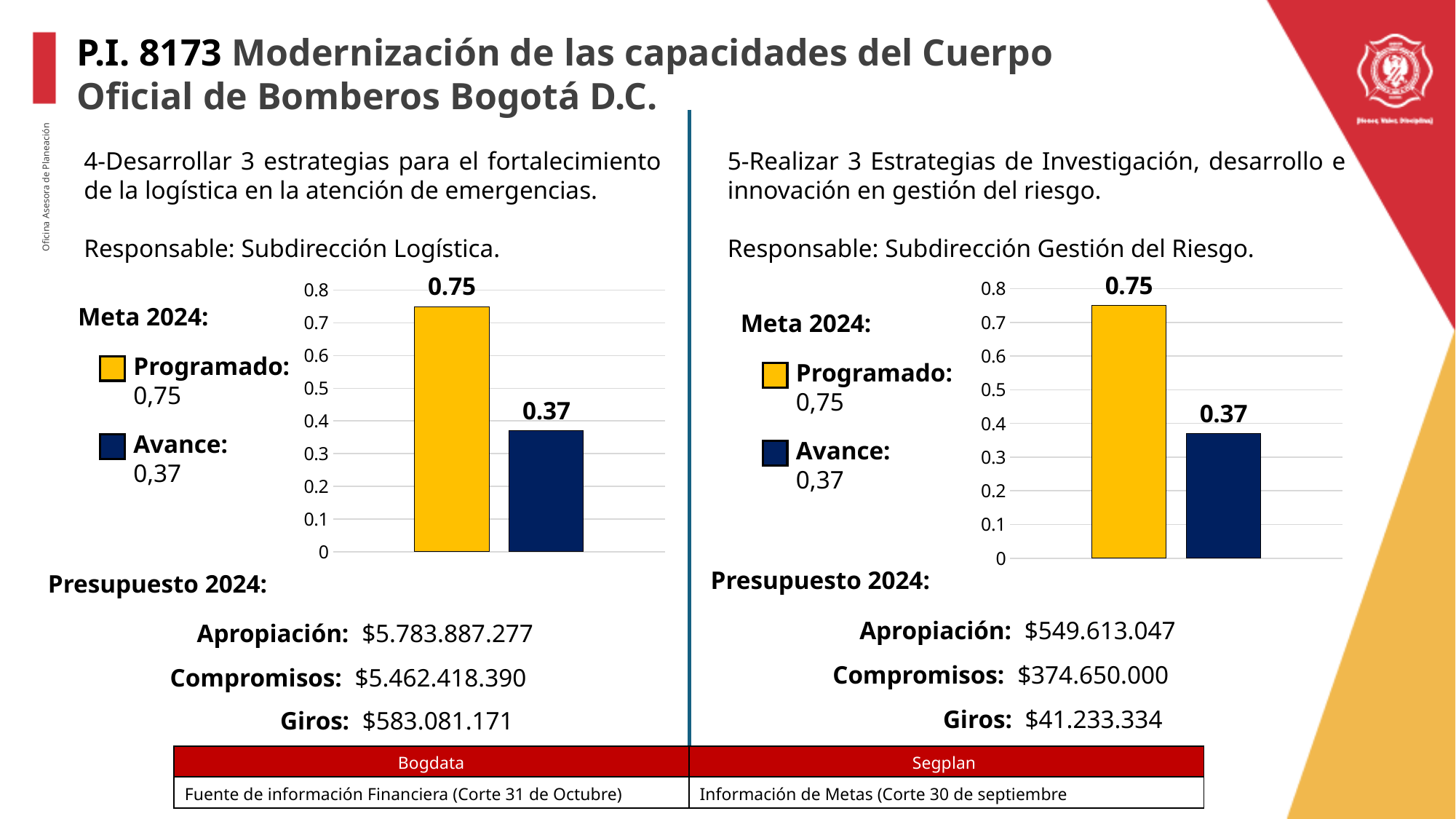
How many bars are plotted in the right chart? 2 In the left chart, what colour is the Programado bar? Yellow What type of chart is used on the left side of the slide? Bar chart In the left chart, what is the difference between the Programado and Avance values? 0.38 In the left chart, is the Avance value greater or less than 0.4? less In the left chart, which bar is higher, Programado or Avance? Programado In the right chart, which bar is the lowest? Avance In the left chart (goal 4, Subdirección Logística), what is the value of the Programado bar? 0.75 In the right chart (goal 5, Subdirección Gestión del Riesgo), what is the value of the Avance bar? 0.37 In the right chart, what is the difference between the Programado and Avance values? 0.38 In the left chart (goal 4, Subdirección Logística), what is the value of the Avance bar? 0.37 In the right chart (goal 5, Subdirección Gestión del Riesgo), what is the value of the Programado bar? 0.75